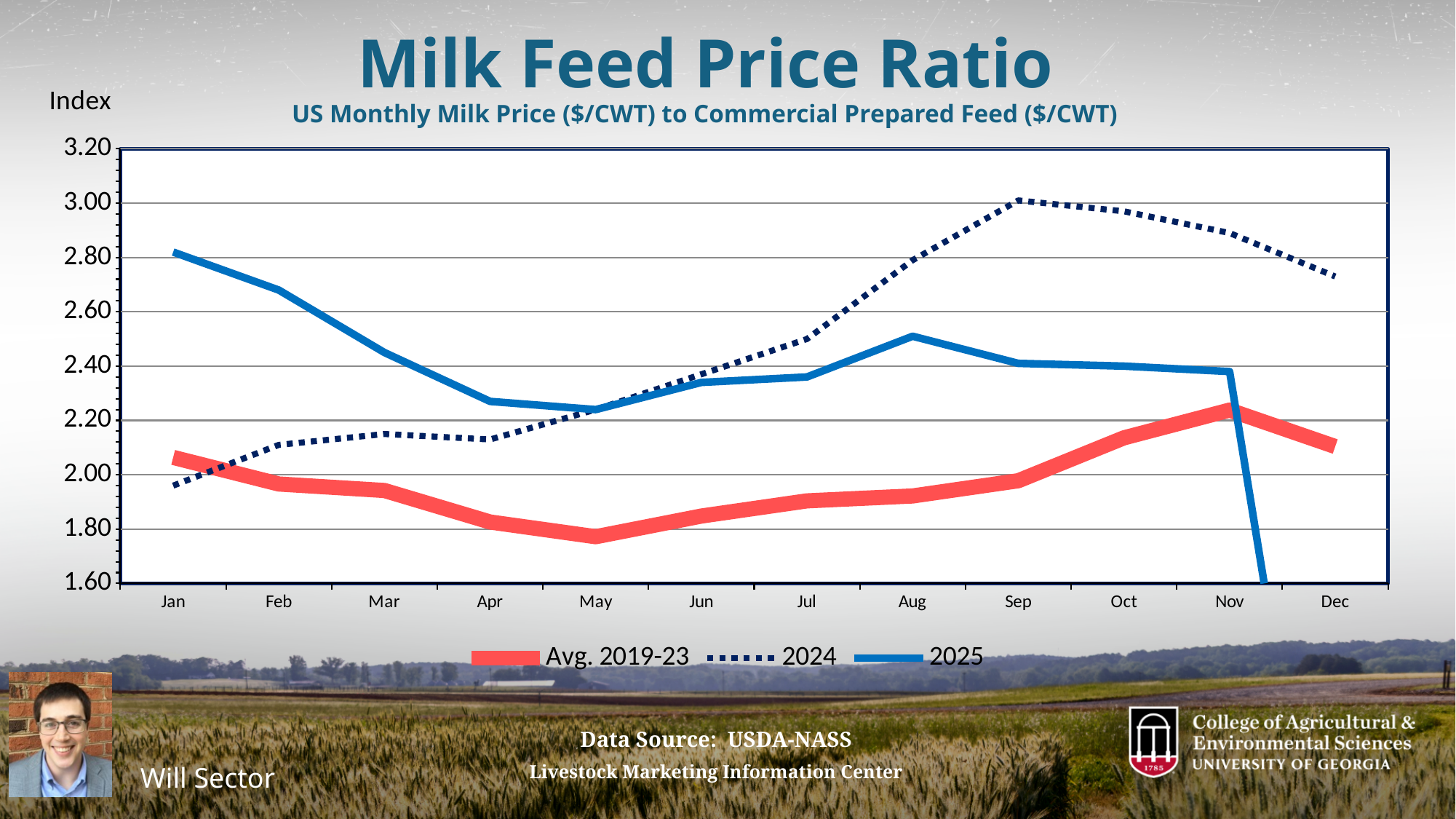
Is the 2025 value for Jan greater or less than 2.60? greater In which month does the 2025 series reach its highest value? Jan Which series has the larger value in Sep, 2024 or 2025? 2024 Is the 2024 value for Sep greater or less than 2.80? greater Is the Avg. 2019-23 value for May greater or less than 2.00? less What is the title of the chart? Milk Feed Price Ratio Does the 2025 series rise or fall from Jan to Apr? fall What kind of chart is shown on the slide? line chart In which month does the 2024 series reach its highest value? Sep How many series does the legend list? 3 In which month is the Avg. 2019-23 series at its lowest? May How many months are shown along the x axis? 12